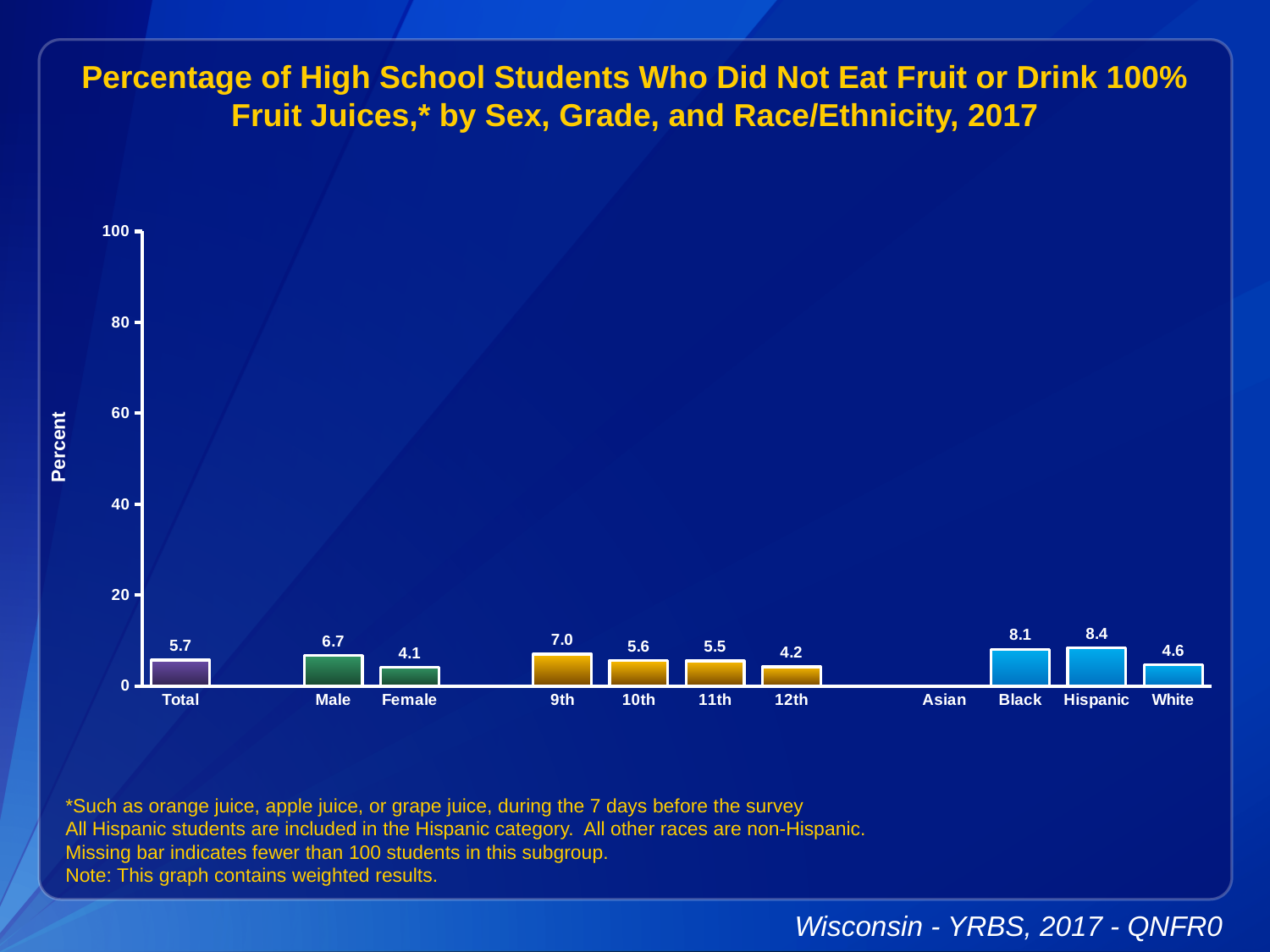
Which is larger, the value for Black or the value for White? Black What kind of chart is this? bar chart What is the value for Total? 5.7 Which category has the highest value? Hispanic Which category has the lowest plotted value? Female Is the value for 12th grade greater or less than 20? less How many categories have a bar plotted? 11 What is the value for 9th grade? 7.0 Which category has no bar shown? Asian What is the difference between the Male and Female values? 2.6 What is the value for Male? 6.7 What is the value for Hispanic? 8.4